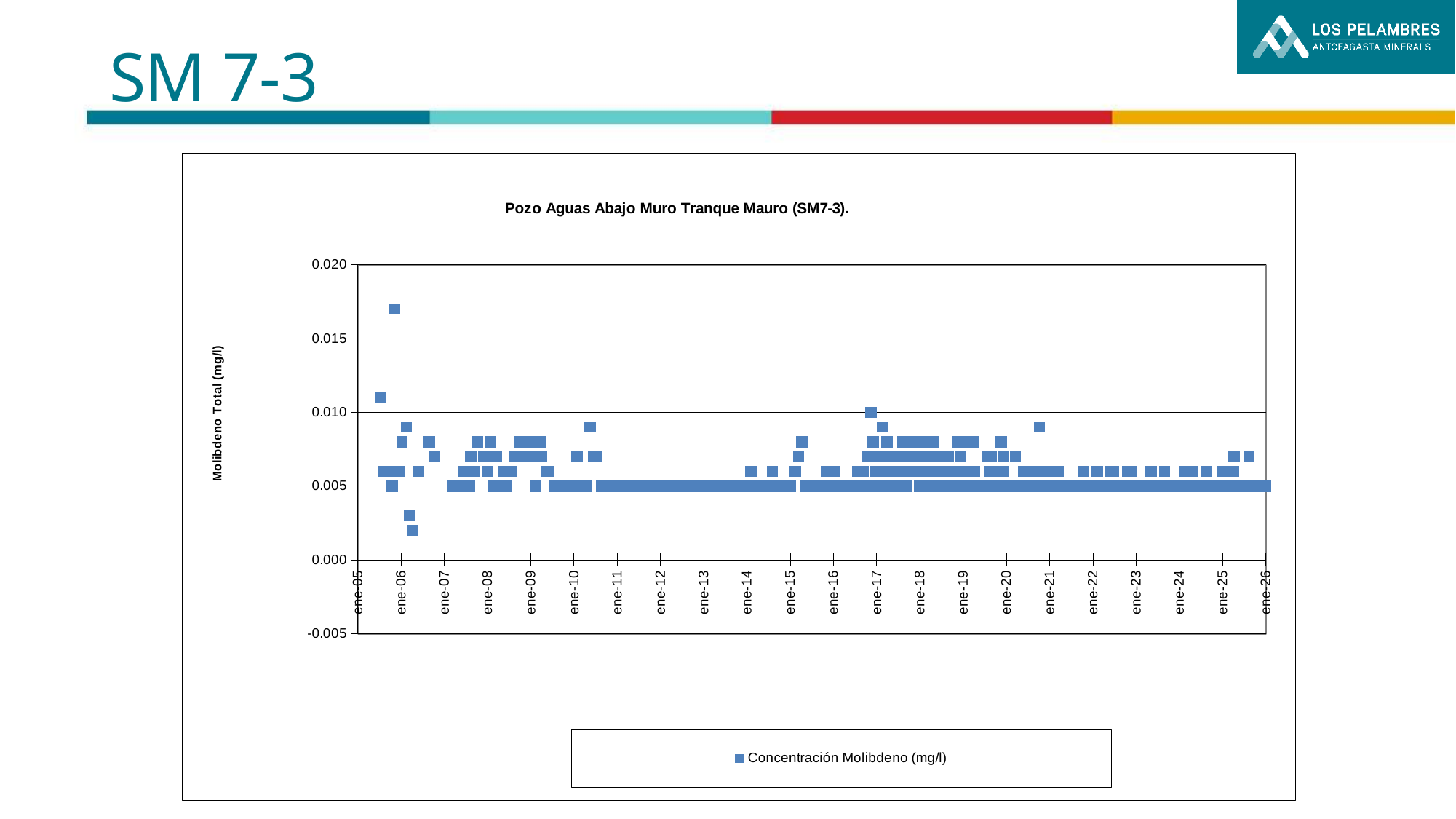
Are the plotted values between ene-11 and ene-14 greater or less than 0.010? less Is the lowest plotted value on the chart greater or less than 0.005? less What is the legend entry for the plotted series? Concentración Molibdeno (mg/l) Is the highest plotted value near ene-17 greater or less than 0.015? less What is the title of the chart? Pozo Aguas Abajo Muro Tranque Mauro (SM7-3). What is the highest tick value shown on the y axis? 0.020 How many series does the legend list? 1 Does the highest plotted point occur before or after ene-07? before How many year labels are shown on the x axis? 22 What kind of chart is shown on the slide? scatter chart